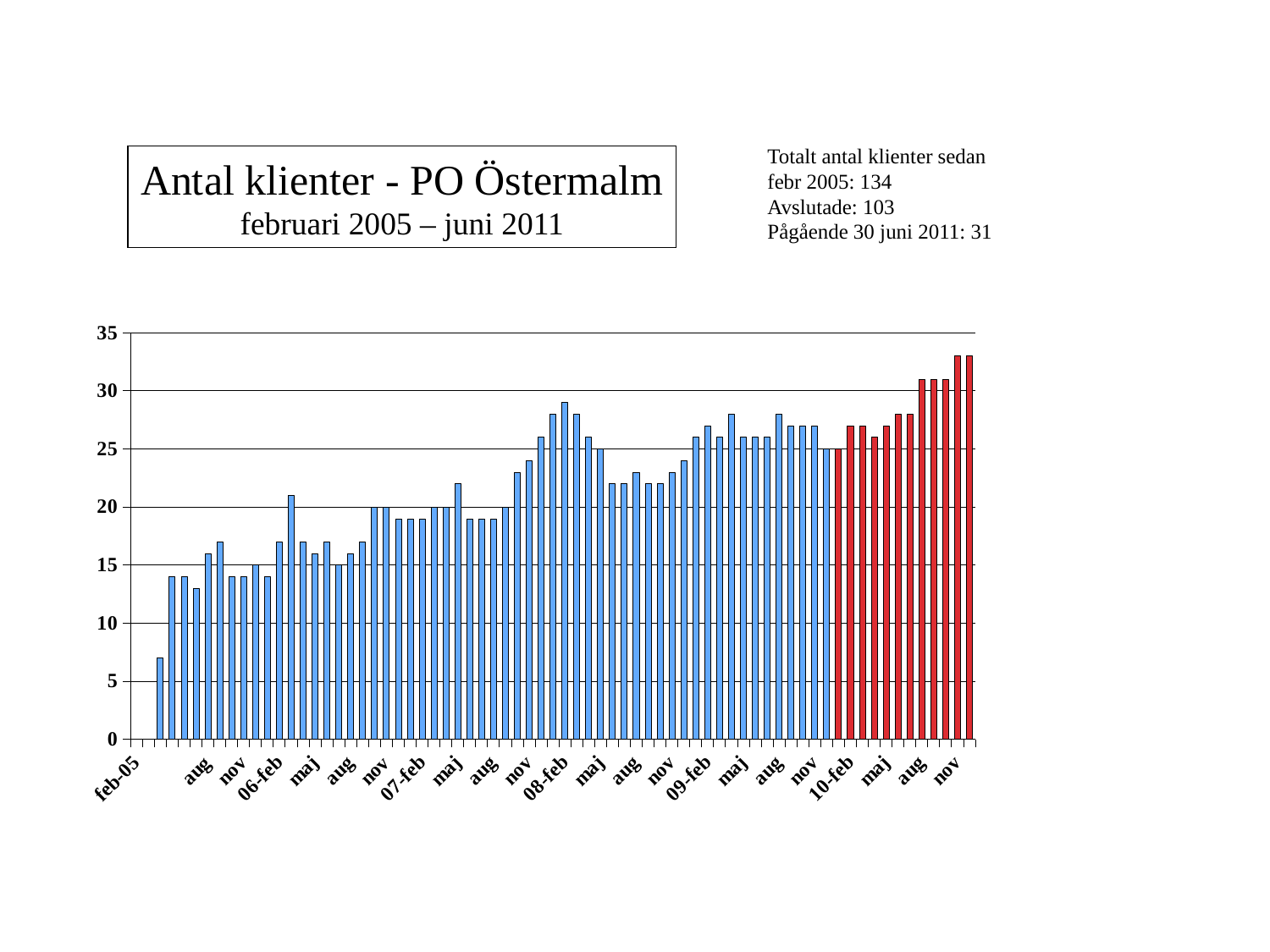
What kind of chart is shown on the slide? bar chart What is the title of the chart on the slide? Antal klienter - PO Östermalm februari 2005 – juni 2011 Is the value for 07-feb greater or less than 15? greater What colour are the bars at the right end of the chart, after the blue bars? red Do the values generally rise or fall from feb-05 to the end of the x axis? rise Is the value for 09-feb greater or less than 20? greater Which has the larger value, 06-feb or 10-feb? 10-feb Is the value for 08-feb greater or less than 25? greater